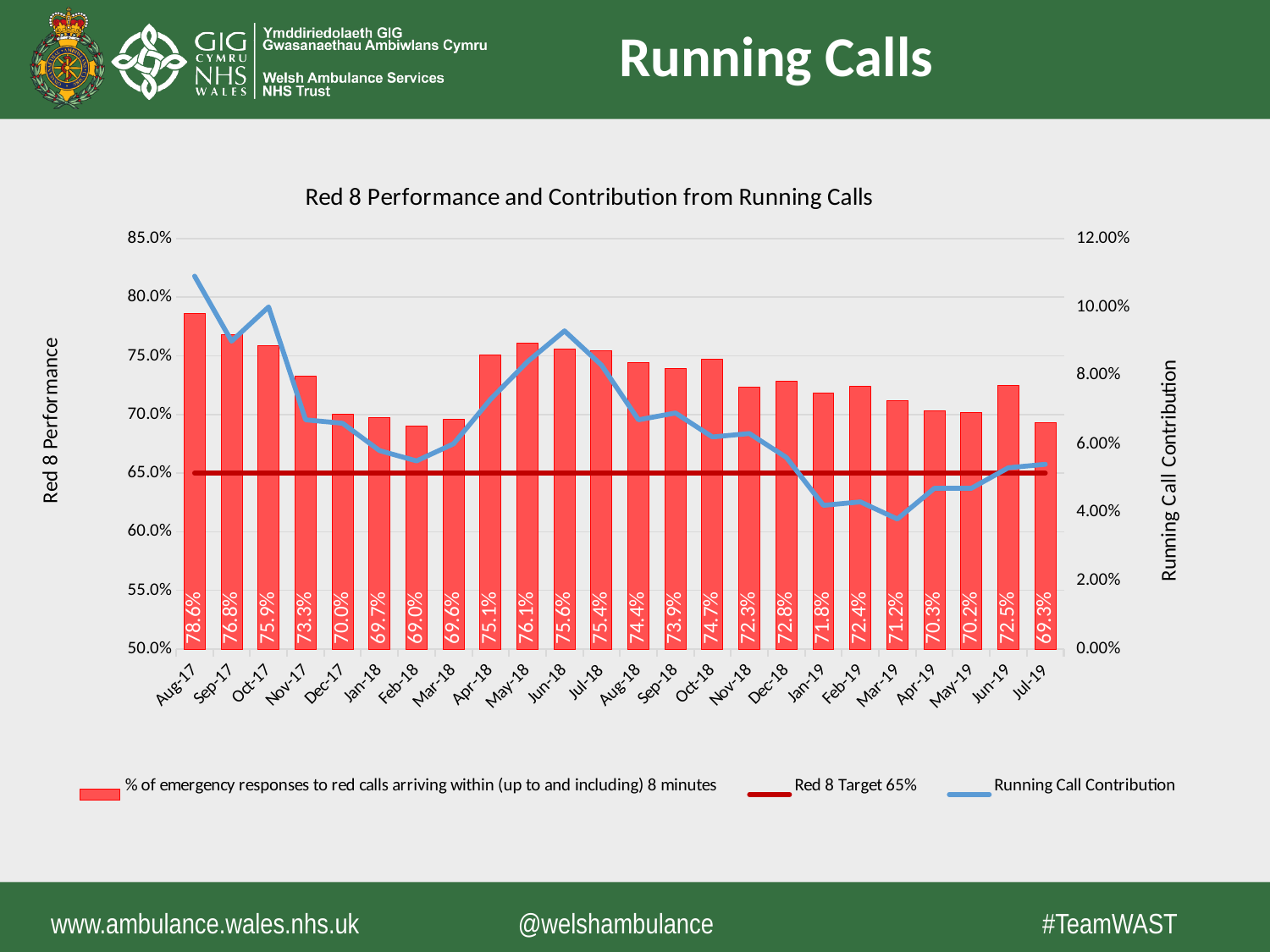
What is the Red 8 Performance value for Aug-17? 78.6% What value does the Red 8 Target line represent? 65% Is the Running Call Contribution value for Aug-17 greater or less than 10.00%? greater What is the difference between the Red 8 Performance values for Aug-17 and Jul-19? 9.3% Which month has the lowest Red 8 Performance bar? Feb-18 Which month has the highest Red 8 Performance bar? Aug-17 How many months are shown on the x axis of the chart? 24 Which month has the higher Red 8 Performance value, May-18 or Nov-18? May-18 What is the Red 8 Performance value for Jul-19? 69.3% What is the Red 8 Performance value for Feb-18? 69.0% How many series does the legend list? 3